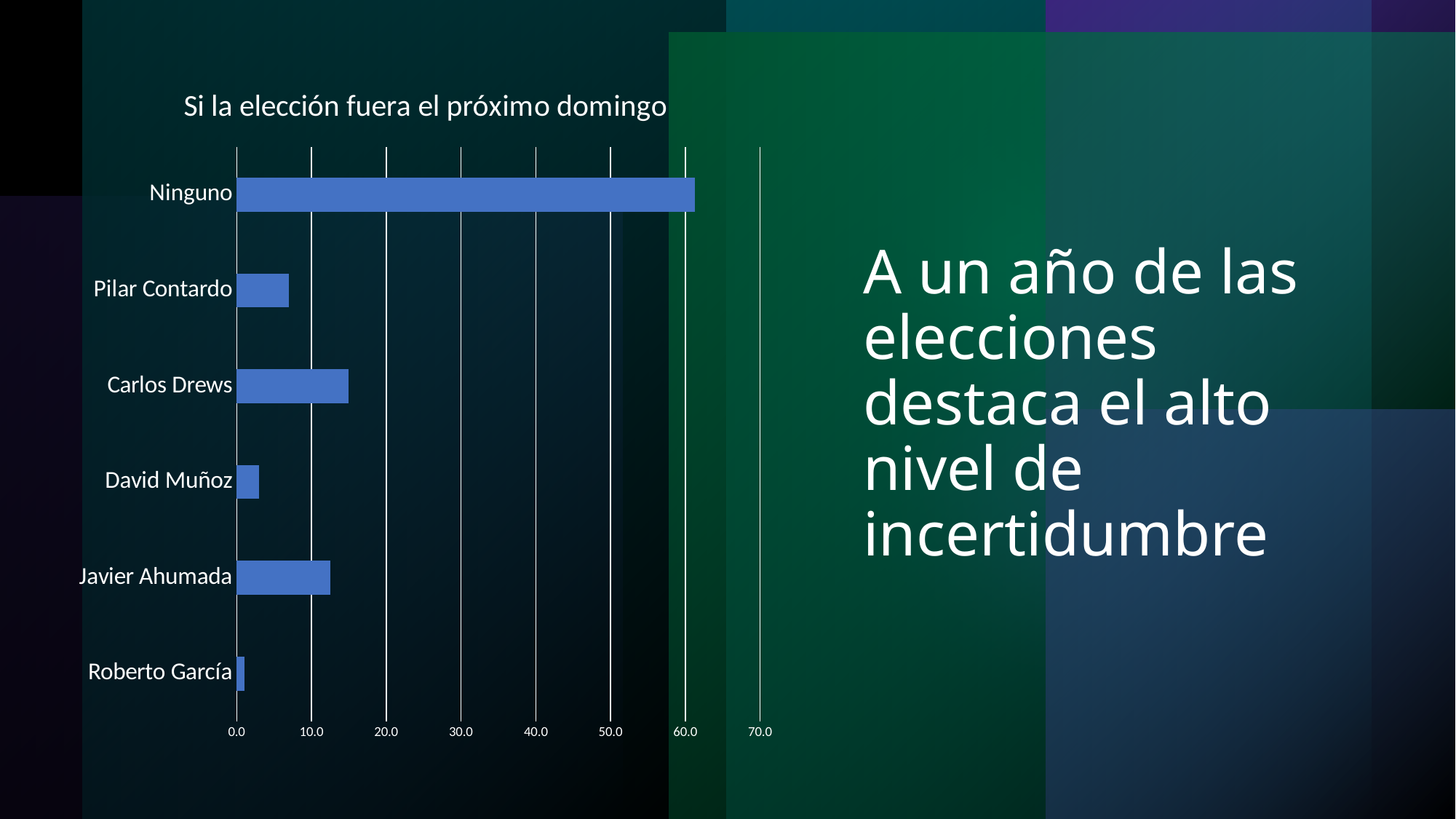
What kind of chart is shown on the slide? Bar chart What is the highest value shown on the horizontal axis? 70.0 Is the value for Carlos Drews greater or less than 10.0? greater Which has a larger value, Carlos Drews or Javier Ahumada? Carlos Drews Is the value for Ninguno greater or less than 50.0? greater Is the value for Pilar Contardo greater or less than 10.0? less Which category has the highest value? Ninguno What is the title of the chart? Si la elección fuera el próximo domingo Which has a larger value, Pilar Contardo or David Muñoz? Pilar Contardo Which category has the lowest value? Roberto García How many categories are shown in the chart? 6